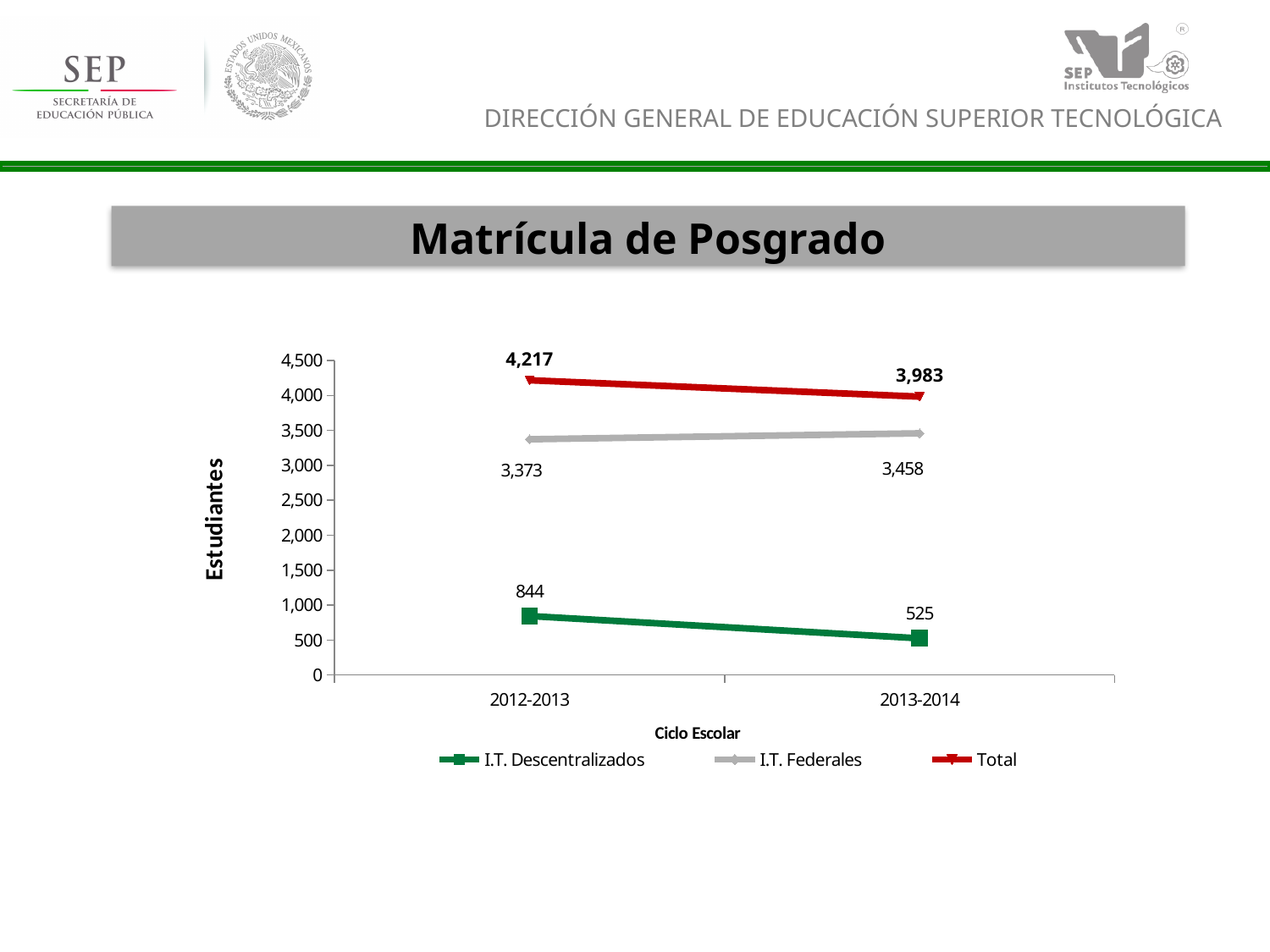
What is the Total value for 2012-2013? 4,217 What is the difference between the Total values for 2012-2013 and 2013-2014? 234 What kind of chart is shown on the slide? line chart Is the value for I.T. Descentralizados in 2012-2013 larger or smaller than in 2013-2014? larger What is the Total value for 2013-2014? 3,983 What is the title of the chart? Matrícula de Posgrado What is the value for I.T. Descentralizados in 2012-2013? 844 What is the value for I.T. Federales in 2013-2014? 3,458 Which school cycle has the higher value for I.T. Federales? 2013-2014 Which school cycle has the lower value for I.T. Descentralizados? 2013-2014 Does the Total series rise or fall from 2012-2013 to 2013-2014? fall How many series does the legend list? 3